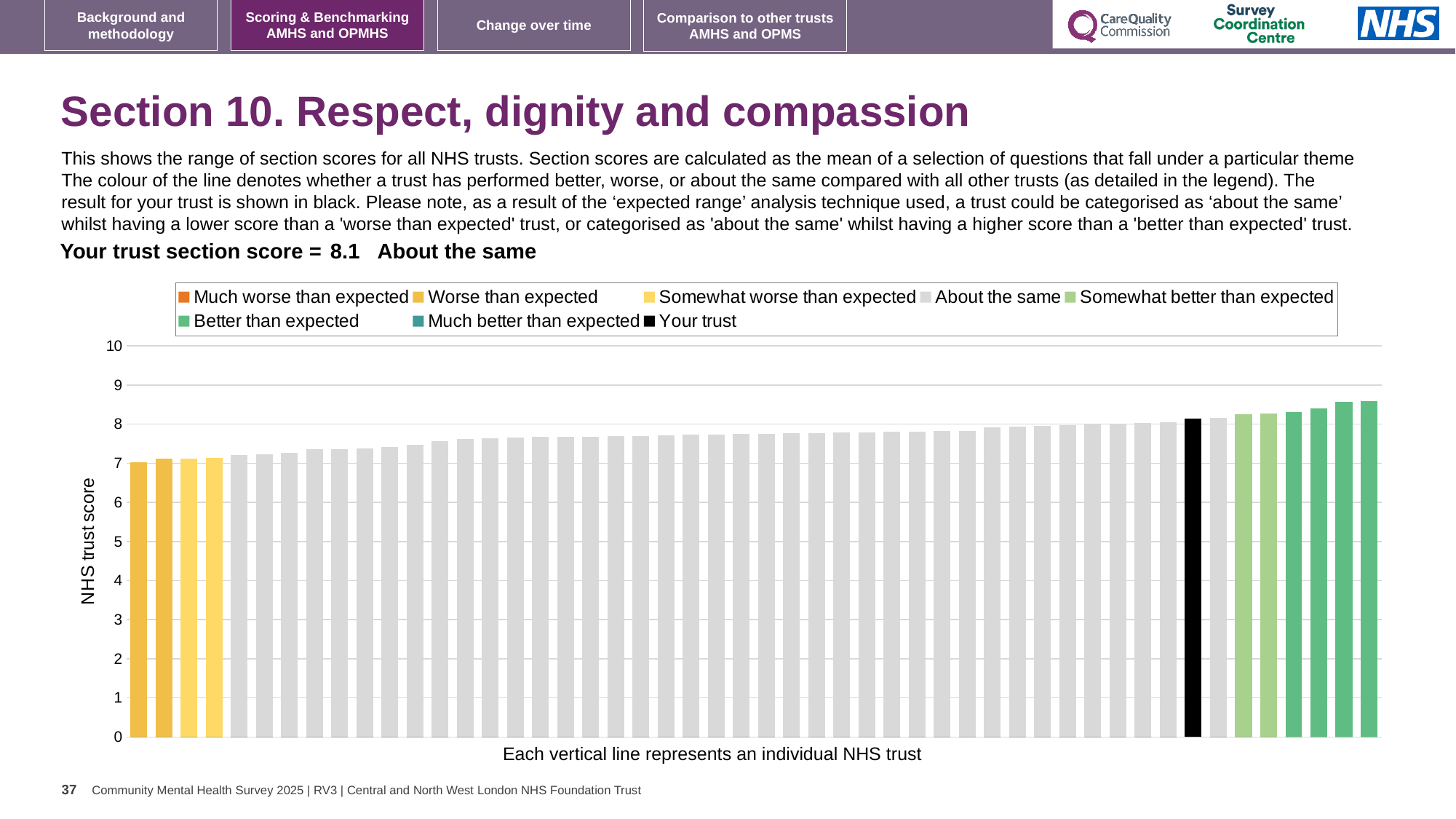
Is the value of the black 'Your trust' bar greater or less than 8? greater What is the section score for your trust shown on the slide? 8.1 Is the value of the leftmost (lowest) bar greater or less than 8? less Is the tallest bar taller or shorter than the black 'Your trust' bar? taller How many entries does the chart legend list? 8 Which legend category does the tallest bar belong to? Better than expected Which legend category is your trust placed in for this section? About the same What colour is the bar representing your trust? black Do the bar values rise or fall moving from left to right along the x axis? rise What kind of chart is shown on the slide? bar chart What is the label on the vertical axis of the chart? NHS trust score Is the value of the rightmost (highest) bar greater or less than 9? less